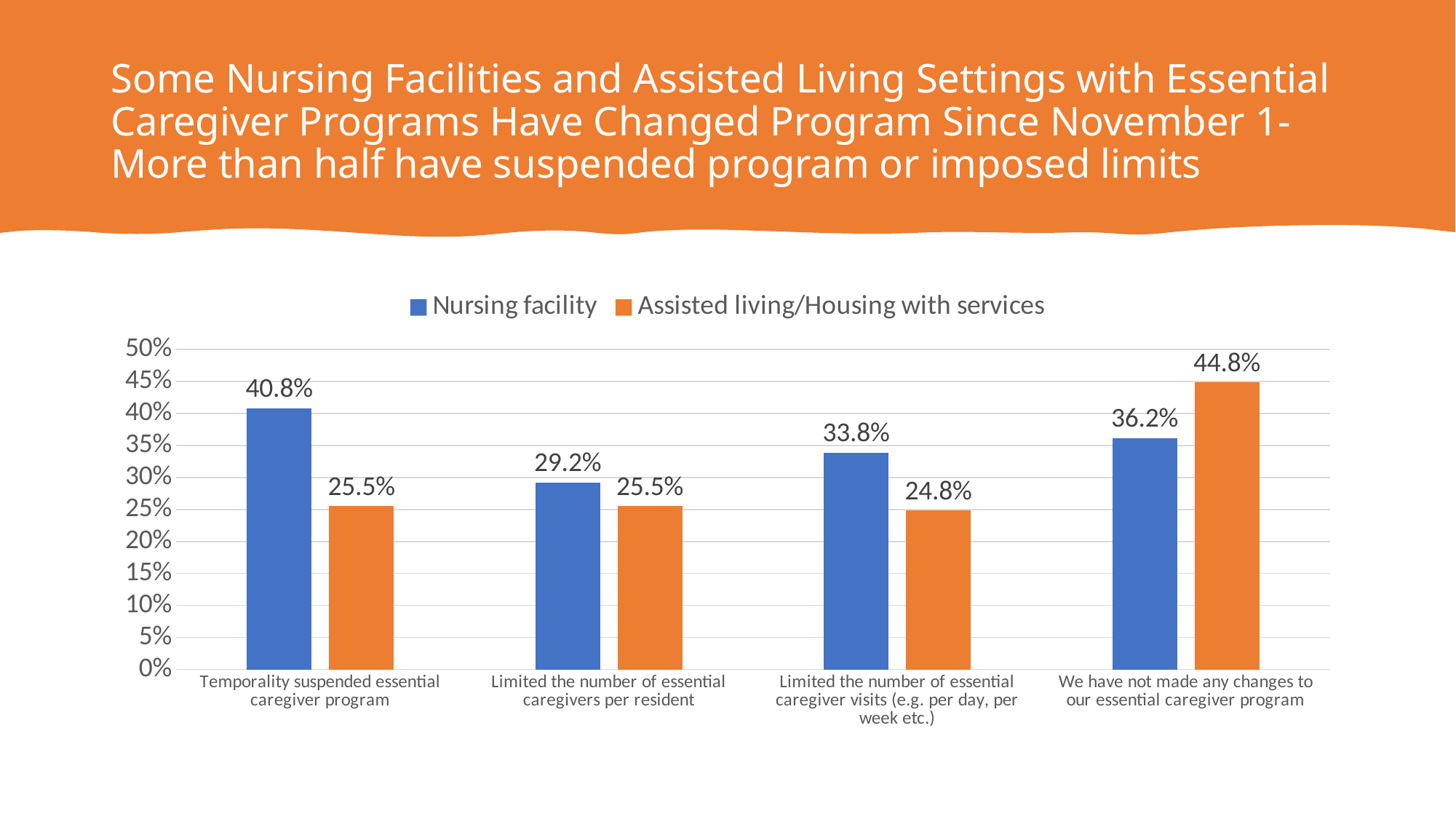
What kind of chart is shown on the slide? Bar chart Which category has the lowest Assisted living/Housing with services value? Limited the number of essential caregiver visits (e.g. per day, per week etc.) How many series does the legend list? 2 What is the difference between the Nursing facility and Assisted living/Housing with services values for "Temporality suspended essential caregiver program"? 15.3% What is the Nursing facility value for "Limited the number of essential caregiver visits (e.g. per day, per week etc.)"? 33.8% What is the Assisted living/Housing with services value for "We have not made any changes to our essential caregiver program"? 44.8% Which colour represents the Nursing facility series? Blue How many categories are shown on the x axis? 4 What is the Assisted living/Housing with services value for "Limited the number of essential caregivers per resident"? 25.5% What is the Nursing facility value for "Temporality suspended essential caregiver program"? 40.8% For "We have not made any changes to our essential caregiver program", which series has the larger value: Nursing facility or Assisted living/Housing with services? Assisted living/Housing with services Which category has the highest Nursing facility value? Temporality suspended essential caregiver program